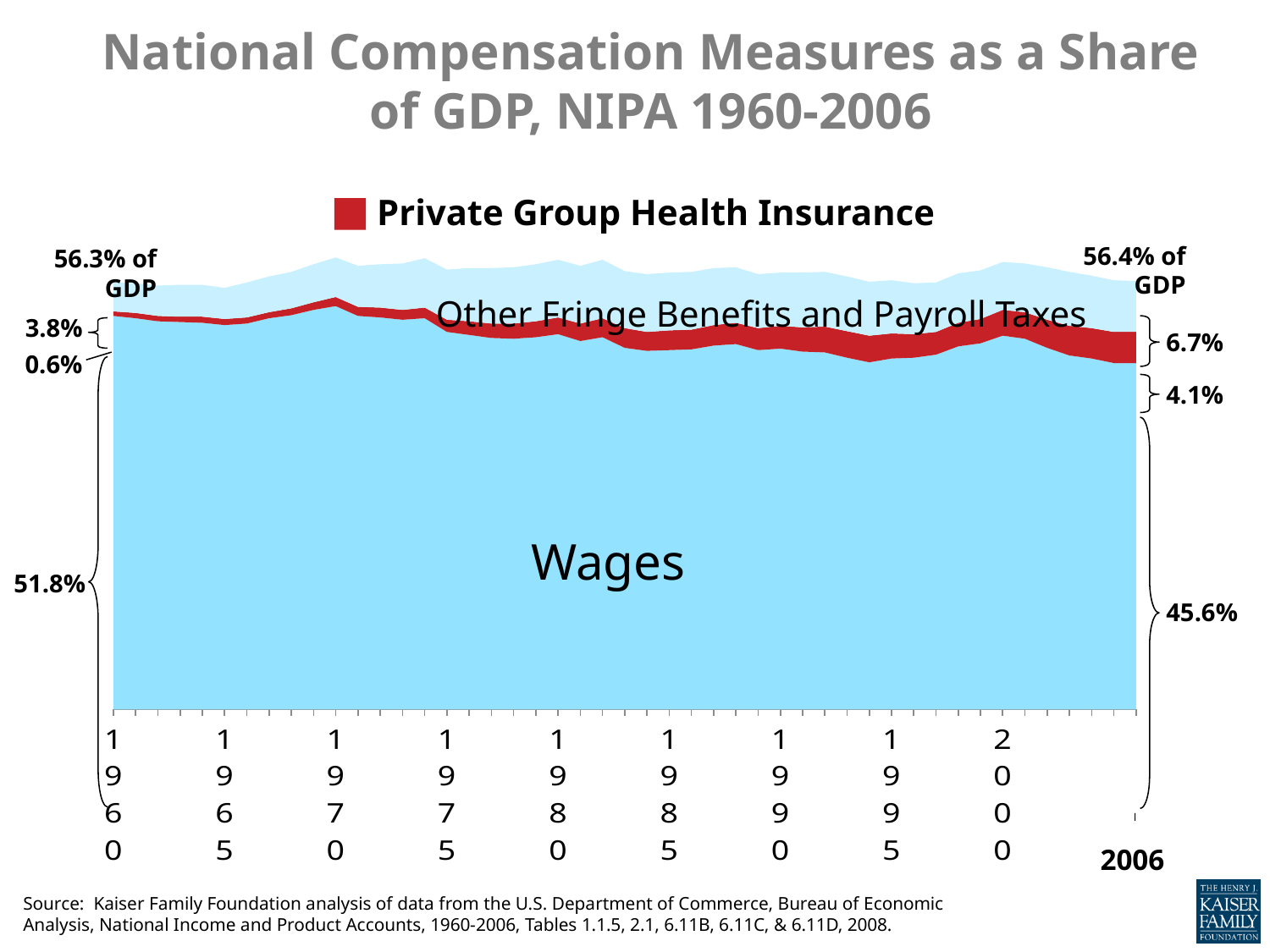
What was the total of all compensation measures as a share of GDP in 2006? 56.4% of GDP What share of GDP did Private Group Health Insurance account for in 1960? 0.6% What kind of chart is shown on the slide? area chart What share of GDP did Other Fringe Benefits and Payroll Taxes account for in 2006? 6.7% What share of GDP did Wages account for in 2006? 45.6% What share of GDP did Private Group Health Insurance account for in 2006? 4.1% By how many percentage points did the Private Group Health Insurance share of GDP increase from 1960 to 2006? 3.5 percentage points What share of GDP did Wages account for in 1960? 51.8% What was the total of all compensation measures as a share of GDP in 1960? 56.3% of GDP Was the Wages share of GDP larger in 1960 or in 2006? 1960 Does the Private Group Health Insurance share of GDP rise or fall from 1960 to 2006? rise By how many percentage points did the Wages share of GDP fall from 1960 to 2006? 6.2 percentage points